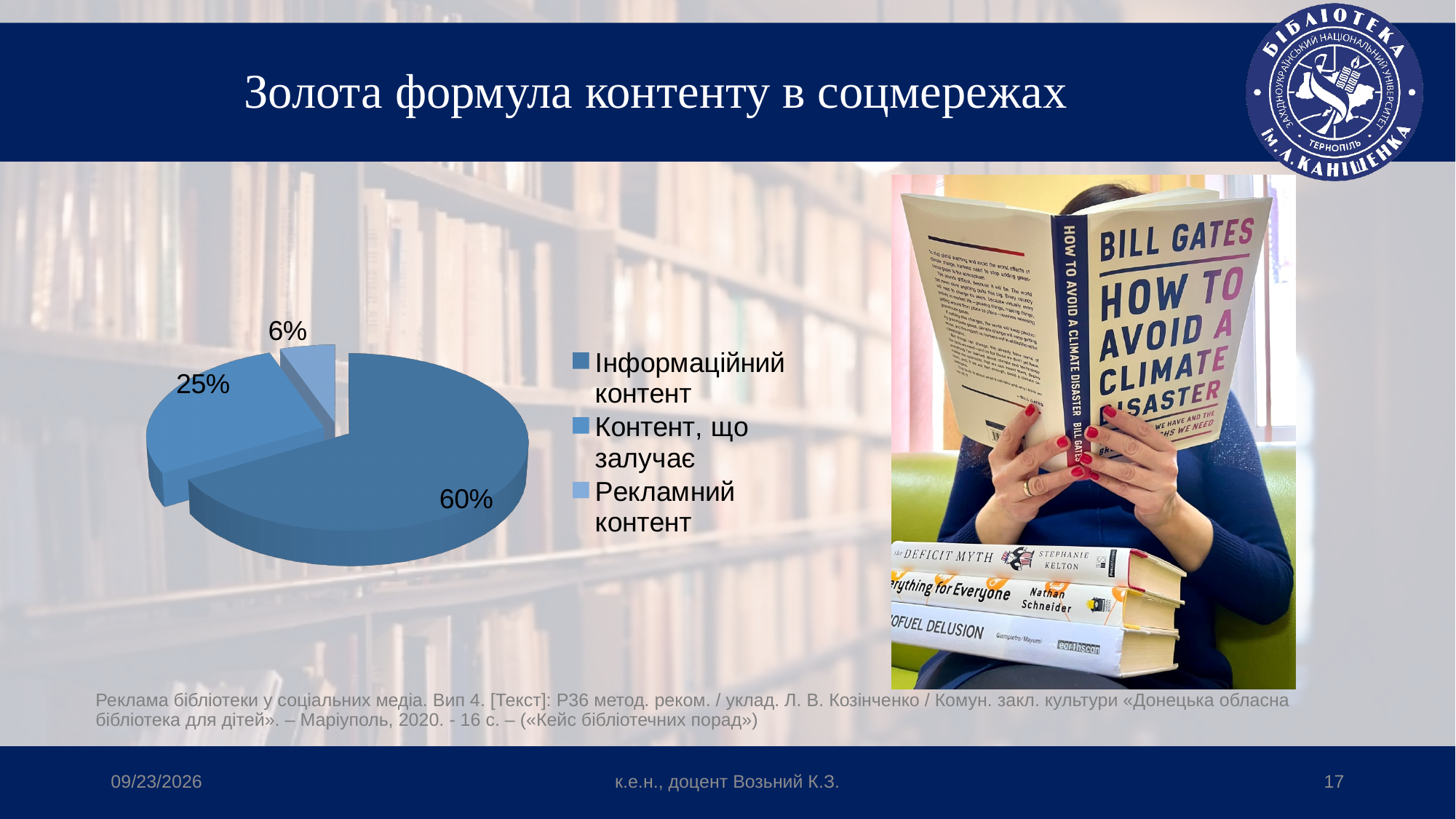
Which category has the smallest slice of the pie? Рекламний контент Which category has the largest slice of the pie? Інформаційний контент What is the difference in percentage points between "Контент, що залучає" and "Рекламний контент"? 19 What share of the pie is labelled for "Рекламний контент"? 6% What is the title of the slide containing the pie chart? Золота формула контенту в соцмережах How many slices does the pie chart have? 3 How many entries does the chart legend list? 3 What is the difference in percentage points between "Інформаційний контент" and "Контент, що залучає"? 35 What share of the pie is labelled for "Інформаційний контент"? 60% What kind of chart is shown on the slide? pie chart What share of the pie is labelled for "Контент, що залучає"? 25% Which is larger: the slice for "Контент, що залучає" or the slice for "Рекламний контент"? Контент, що залучає